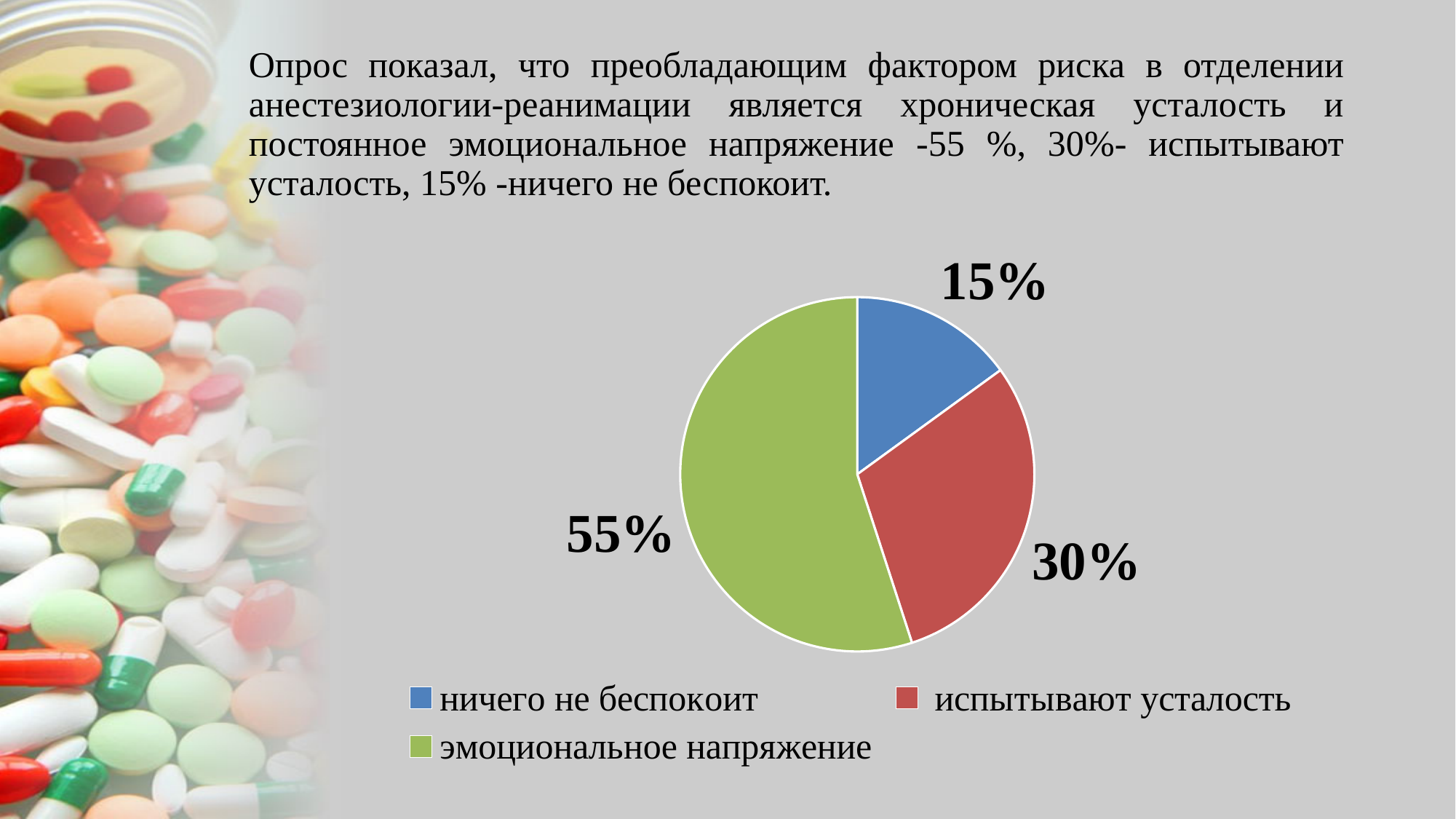
Which is larger: the slice for "испытывают усталость" or the slice for "ничего не беспокоит"? испытывают усталость What colour is the slice for "эмоциональное напряжение"? green What share of the pie does "ничего не беспокоит" have? 15% What is the difference between the shares for "эмоциональное напряжение" and "испытывают усталость"? 25% What is the difference between the shares for "испытывают усталость" and "ничего не беспокоит"? 15% How many entries does the legend list? 3 What share of the pie does "эмоциональное напряжение" have? 55% What kind of chart is shown on the slide? pie chart Which category has the smallest slice of the pie? ничего не беспокоит Which category has the largest slice of the pie? эмоциональное напряжение How many slices does the pie chart have? 3 What share of the pie does "испытывают усталость" have? 30%